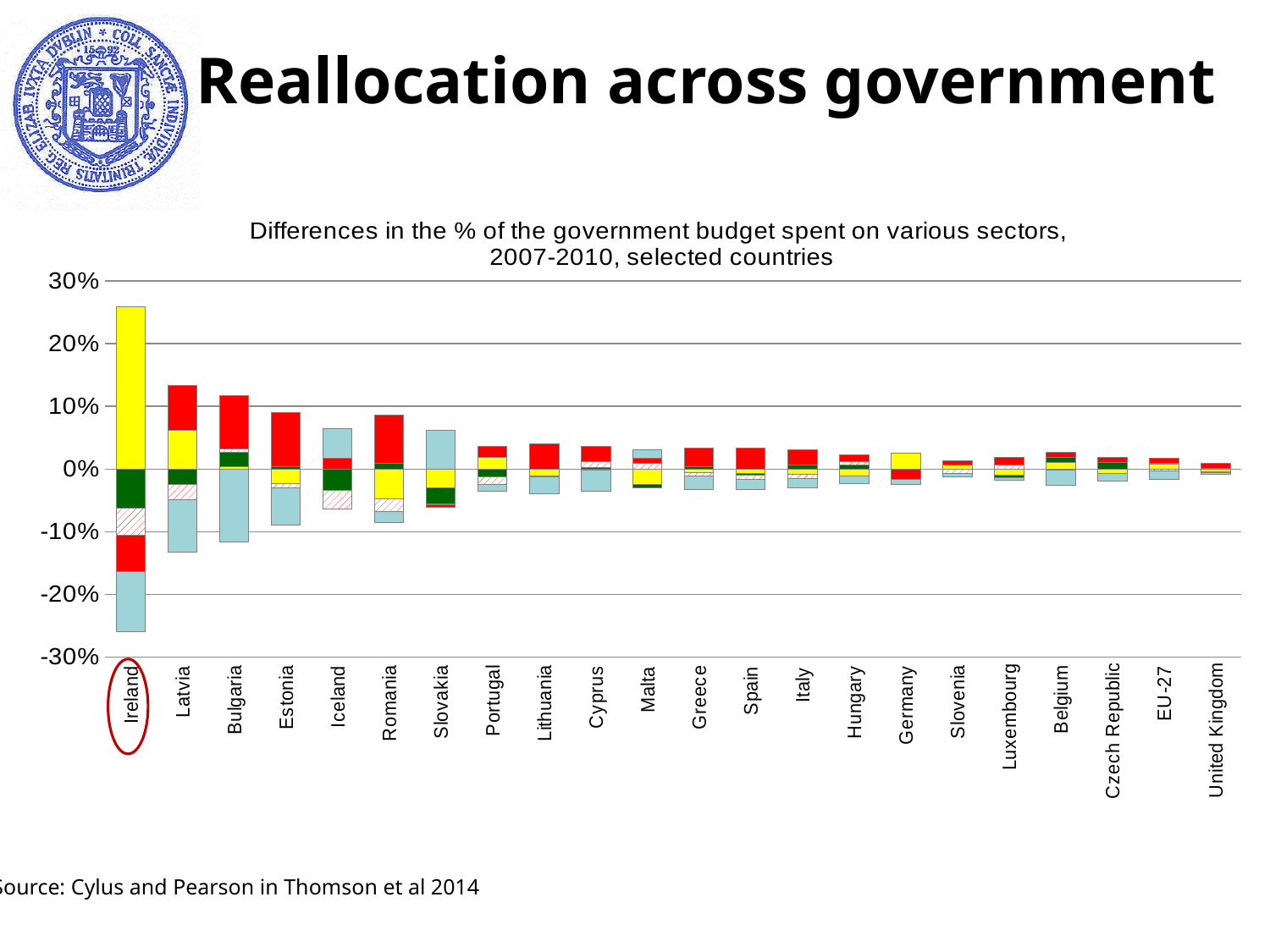
What is the title of the chart? Differences in the % of the government budget spent on various sectors, 2007-2010, selected countries Which country has the tallest positive stacked bar in the chart? Ireland Is the top of the positive stacked bar for Iceland greater or less than 10%? less Is the top of the positive stacked bar for Latvia greater or less than 10%? greater Do the sizes of the stacked bars generally increase or decrease from left to right along the x axis? decrease Is the top of the positive stacked bar for Estonia greater or less than 10%? less What kind of chart is shown on the slide? Bar chart Which country's label is circled in red on the x axis? Ireland Which has the taller positive stacked bar, Ireland or Latvia? Ireland How many countries or regions are shown on the x axis of the chart? 22